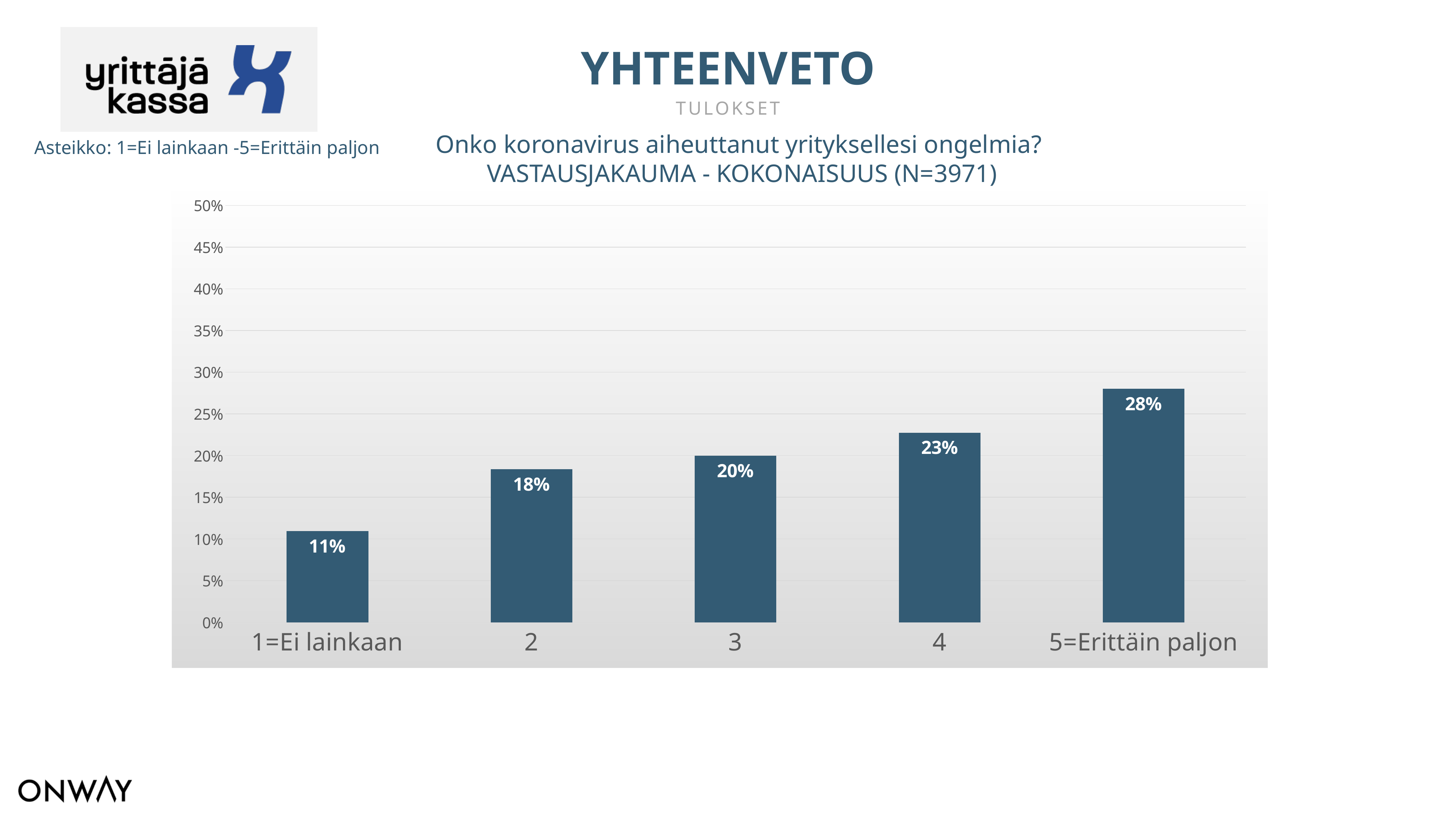
What kind of chart is shown on the slide? bar chart What is the N (number of respondents) stated in the chart title? 3971 What is the value for the category "1=Ei lainkaan"? 11% Which is larger, the value for category 3 or the value for category 4? 4 Which category has the highest value? 5=Erittäin paljon Which category has the lowest value? 1=Ei lainkaan Do the values rise or fall from left to right along the x axis? rise What is the difference between the values for category 4 and category 2? 5% What is the value for category 3? 20% How many categories are shown on the x axis? 5 What is the value for the category "5=Erittäin paljon"? 28% Is the value for "5=Erittäin paljon" greater or less than 25%? greater